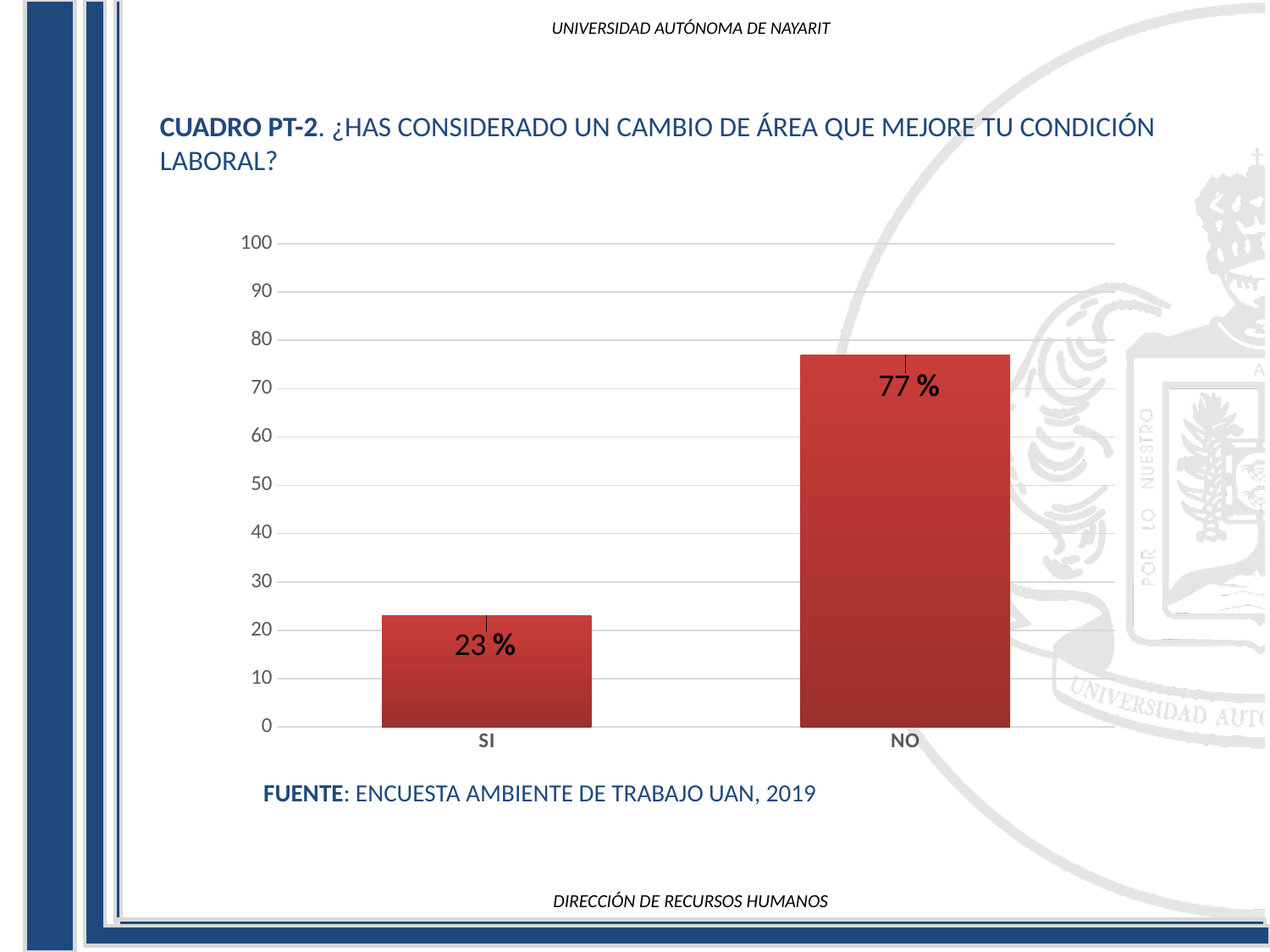
Which category has the lowest value? SI Is the value for NO greater or less than 70? greater What is the value for SI? 23 % What is the value for NO? 77 % Is the value for SI greater or less than 30? less What is the maximum value shown on the y axis? 100 Which is larger, the value for SI or the value for NO? NO How many categories are shown on the x axis? 2 What source is cited below the chart? ENCUESTA AMBIENTE DE TRABAJO UAN, 2019 What is the difference between the values for NO and SI? 54 % What kind of chart is shown on the slide? bar chart Which category has the highest value? NO